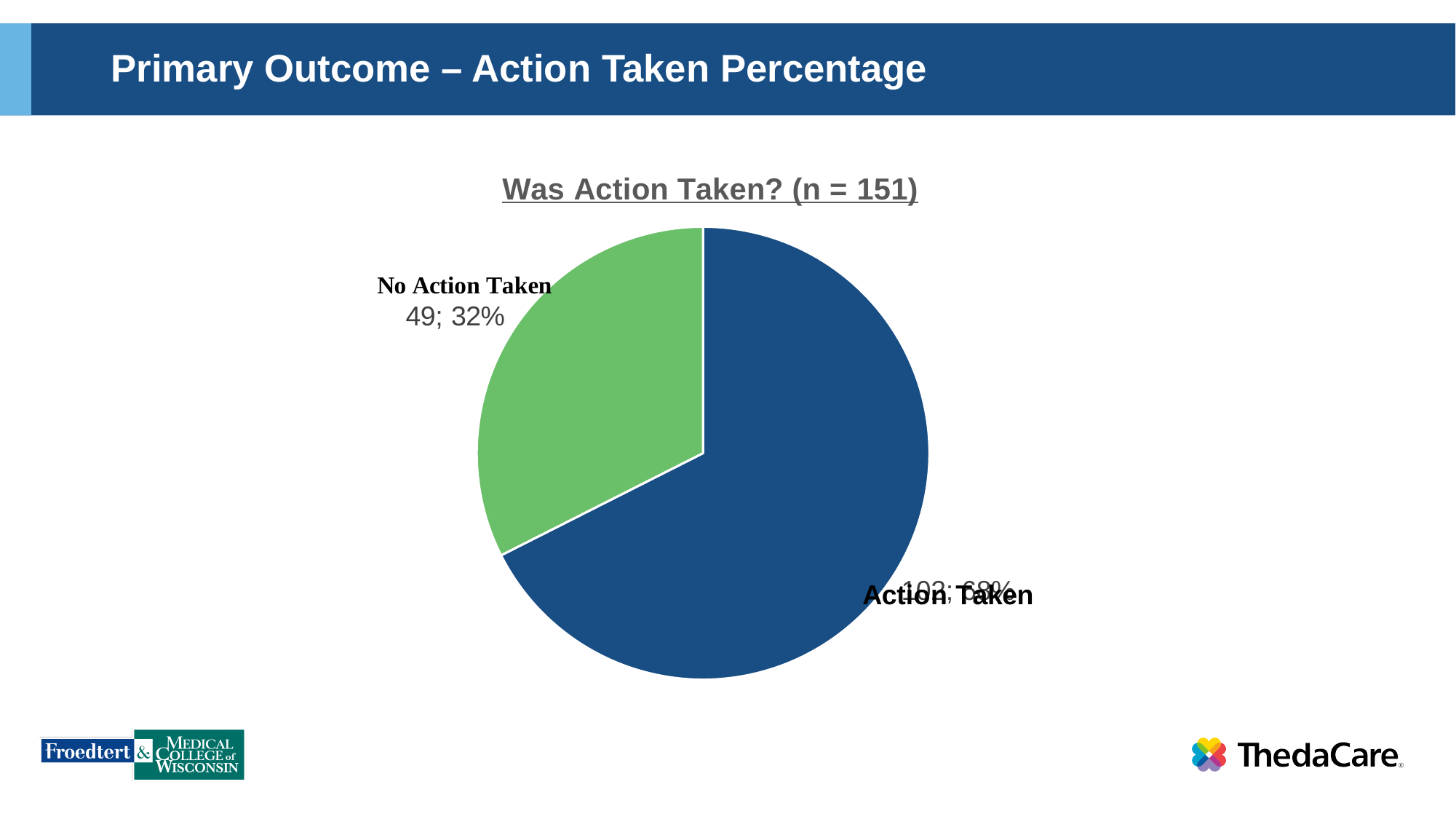
What percentage of the pie is the No Action Taken slice? 32% What is the title of the chart? Was Action Taken? (n = 151) How many slices does the pie chart have? 2 What colour is the No Action Taken slice? green How many cases are in the Action Taken slice? 102 Which is larger, the Action Taken slice or the No Action Taken slice? Action Taken Which slice is the smallest in the pie chart? No Action Taken Which slice is the largest in the pie chart? Action Taken What percentage of the pie is the Action Taken slice? 68% What kind of chart is shown on the slide? pie chart What is the difference in percentage points between the Action Taken and No Action Taken slices? 36 How many cases are in the No Action Taken slice? 49